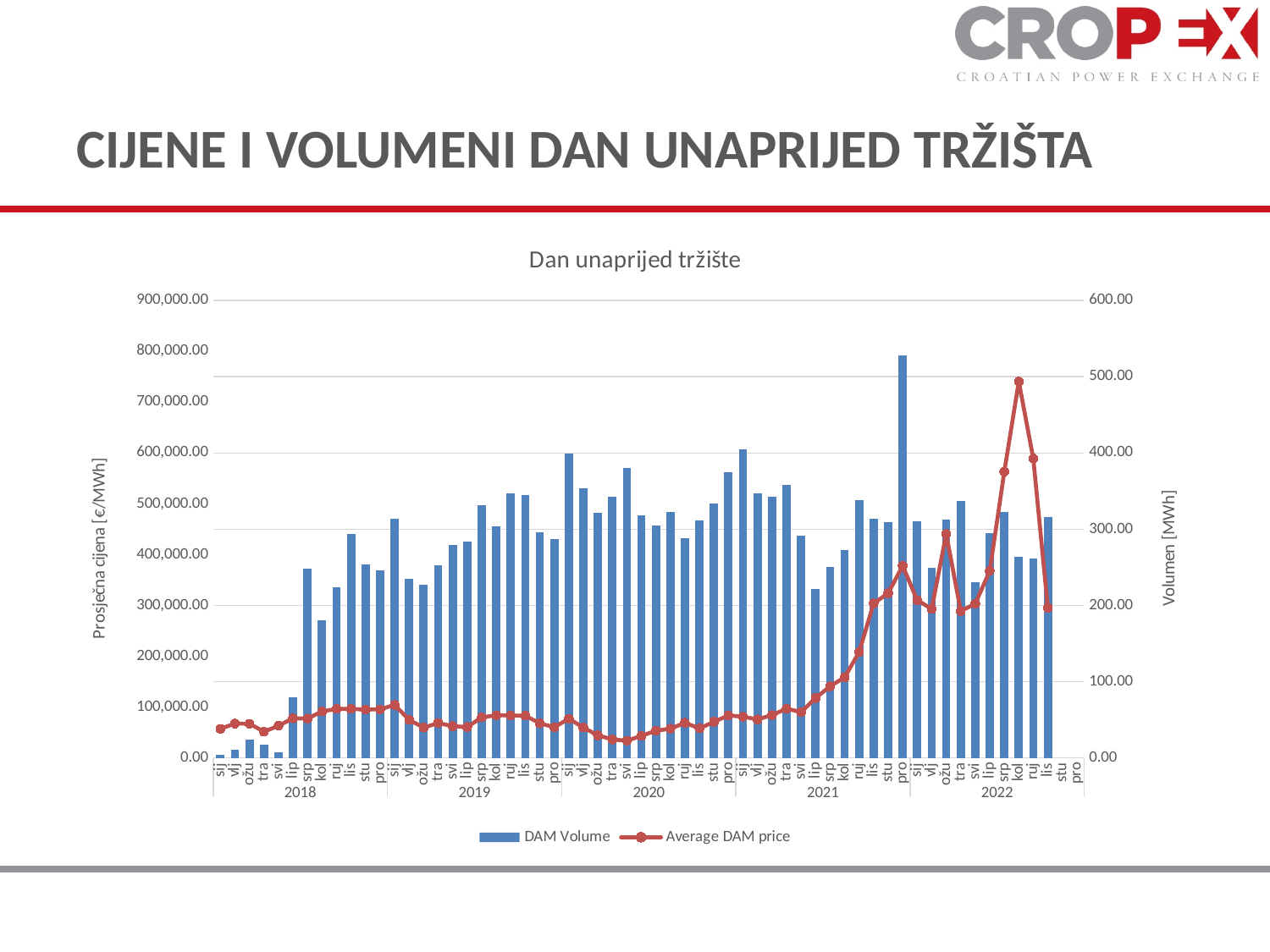
Is the Average DAM price for kol 2022 greater or less than 400.00? greater Is the DAM Volume for sij 2018 greater or less than 100,000.00? less What is the title of the chart? Dan unaprijed tržište Is the DAM Volume for pro 2021 greater or less than 700,000.00? greater What are the two series named in the legend? DAM Volume and Average DAM price Which is larger, the Average DAM price in kol 2022 or in ruj 2022? kol 2022 In which month and year does the Average DAM price line reach its highest point? kol 2022 How many years are labelled along the x axis? 5 How many series does the legend list? 2 In which month and year is the DAM Volume bar the highest? pro 2021 What kind of chart is shown on the slide? A combined bar and line chart Does the Average DAM price rise or fall over the course of 2021? rise